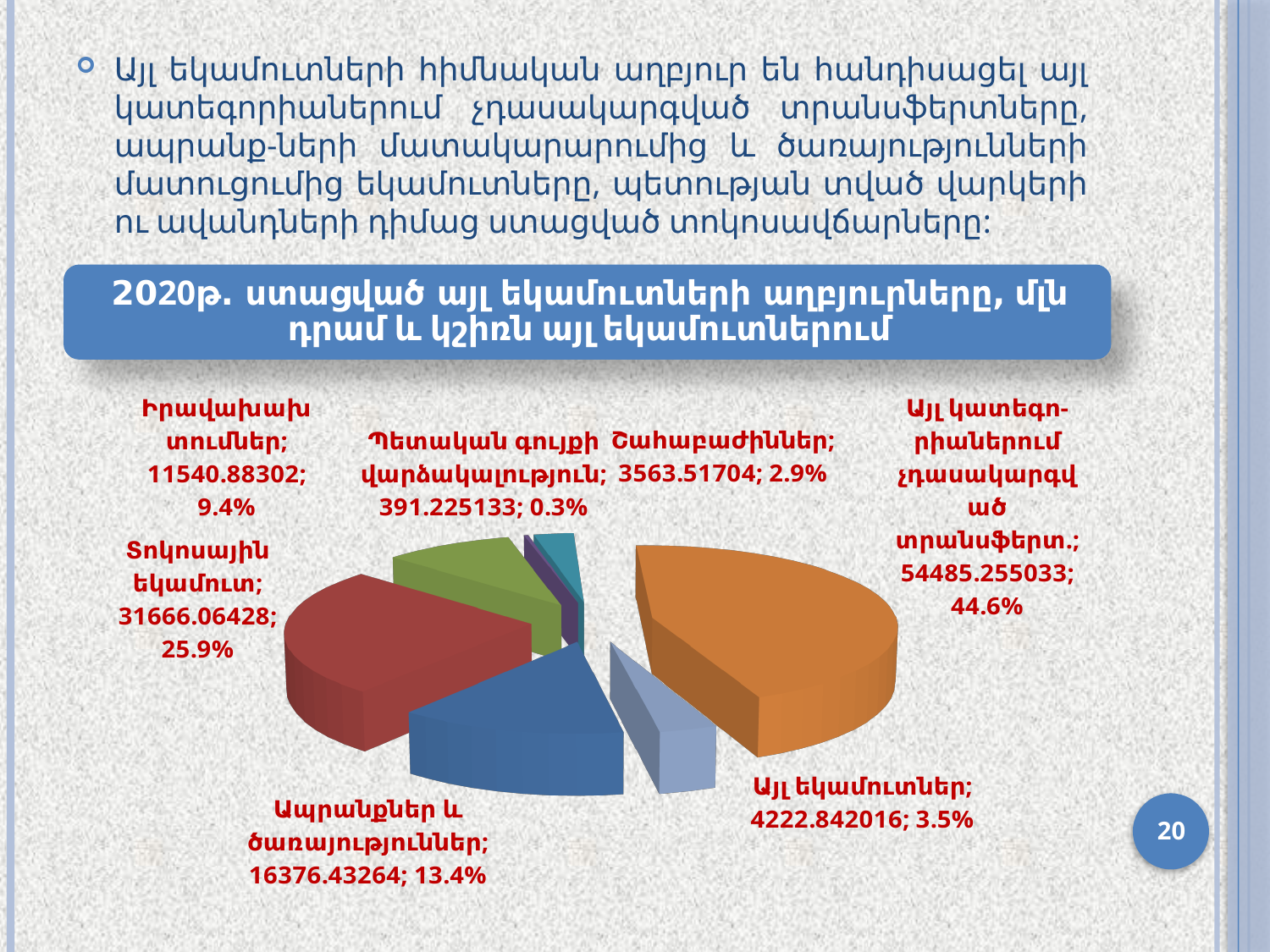
What is the title of the chart? 2020թ. ստացված այլ եկամուտների աղբյուրները, մլն դրամ և կշիռն այլ եկամուտներում What value is shown for Այլ կատեգորիաներում չդասակարգված տրանսֆերտ.? 54485.255033 How many slices does the pie chart have? 7 What percentage is shown for Շահաբաժիններ? 2.9% Which category has the smallest slice of the pie? Պետական գույքի վարձակալություն What kind of chart is shown on the slide? pie chart What value is shown for Ապրանքներ և ծառայություններ? 16376.43264 Which is larger: Այլ եկամուտներ or Շահաբաժիններ? Այլ եկամուտներ Which category has the largest slice of the pie? Այլ կատեգորիաներում չդասակարգված տրանսֆերտ. What share of the pie does Իրավախախտումներ represent? 9.4% What is the difference in percentage share between Տոկոսային եկամուտ and Ապրանքներ և ծառայություններ? 12.5% What value is shown for Տոկոսային եկամուտ in the pie chart? 31666.06428